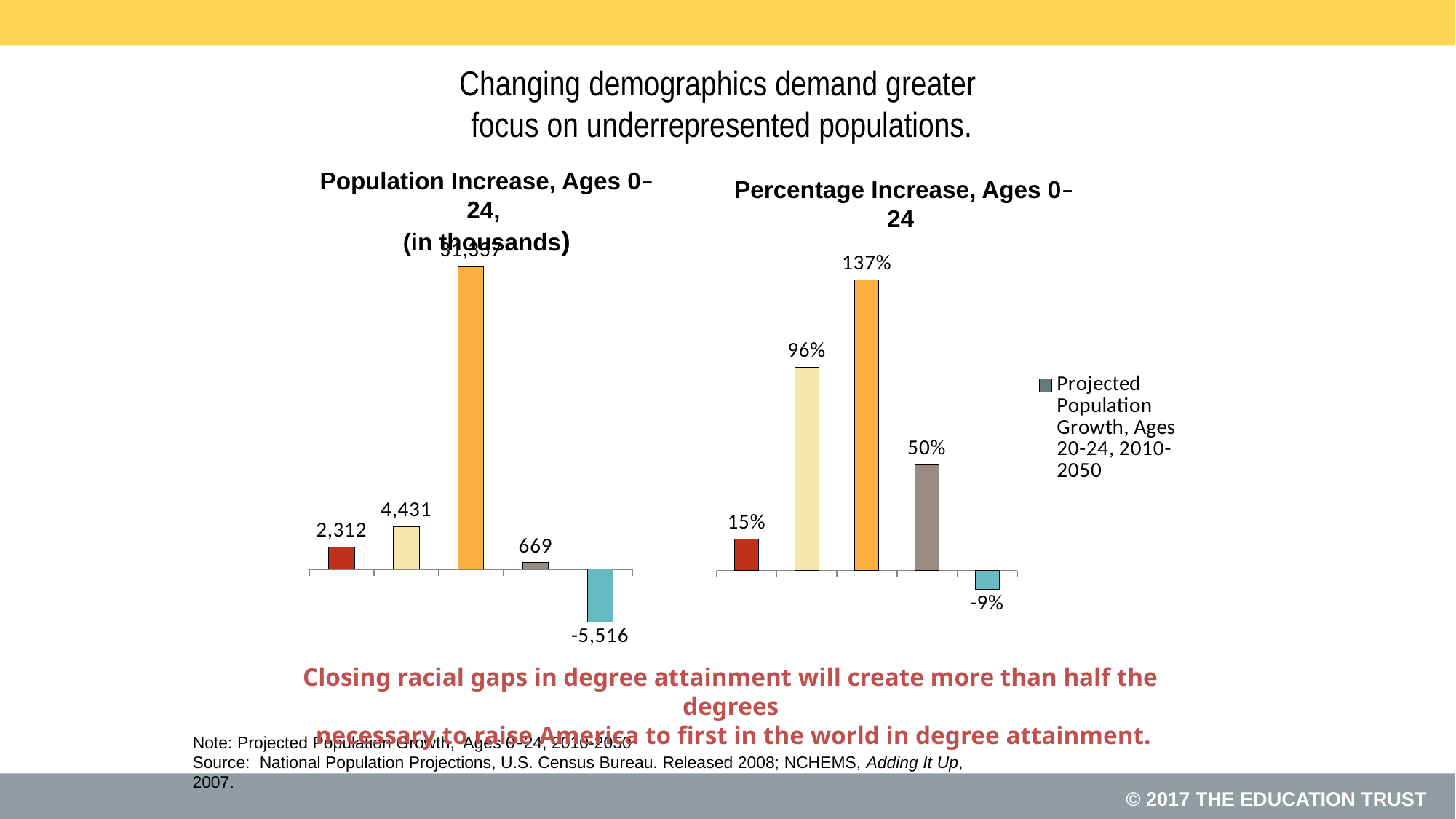
In the 'Percentage Increase, Ages 0-24' chart, what is the difference between the pale yellow bar (96%) and the grey bar (50%)? 46% In the 'Percentage Increase, Ages 0-24' chart, what is the lowest value shown? -9% In the 'Population Increase, Ages 0-24, (in thousands)' chart, what is the value of the grey bar? 669 In the 'Population Increase, Ages 0-24, (in thousands)' chart, what is the difference between the pale yellow bar (4,431) and the red bar (2,312)? 2,119 In the 'Population Increase, Ages 0-24, (in thousands)' chart, what is the value of the red (first) bar? 2,312 How many bars are plotted in the 'Population Increase, Ages 0-24, (in thousands)' chart? 5 What kind of chart is the 'Population Increase, Ages 0-24, (in thousands)' chart? bar chart How many bars are plotted in the 'Percentage Increase, Ages 0-24' chart? 5 In the 'Percentage Increase, Ages 0-24' chart, what is the highest value shown? 137% In the 'Population Increase, Ages 0-24, (in thousands)' chart, what is the value of the teal (last) bar? -5,516 In the 'Percentage Increase, Ages 0-24' chart, which is larger: the red bar or the grey bar? the grey bar How many series does the legend of the 'Percentage Increase, Ages 0-24' chart list? 1